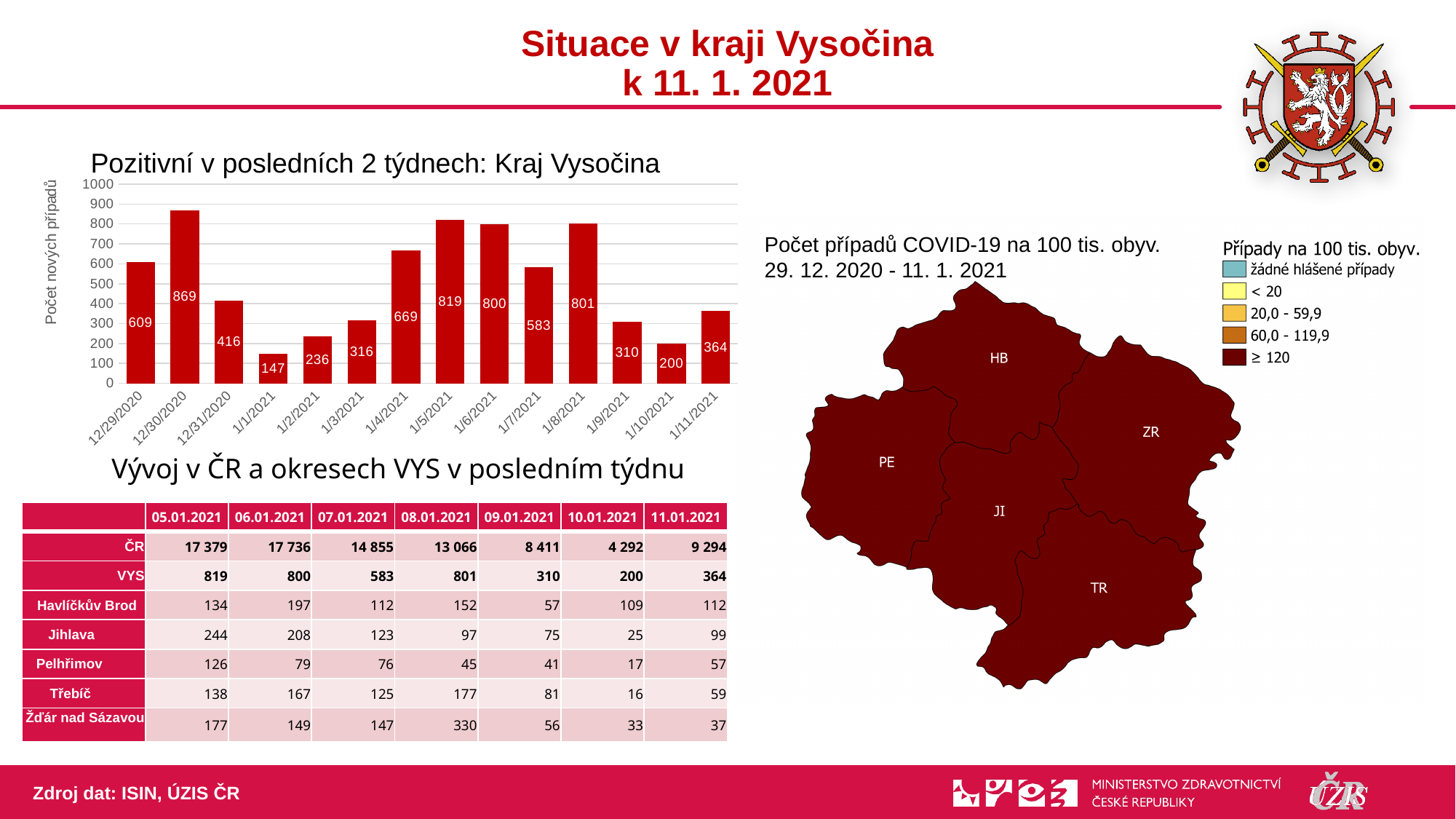
In the chart 'Pozitivní v posledních 2 týdnech: Kraj Vysočina', what is the difference between the values for 12/29/2020 and 12/31/2020? 193 In the chart 'Pozitivní v posledních 2 týdnech: Kraj Vysočina', what is the value for 1/7/2021? 583 In the chart 'Pozitivní v posledních 2 týdnech: Kraj Vysočina', what is the value for 12/30/2020? 869 How many dates (bars) are shown in the chart 'Pozitivní v posledních 2 týdnech: Kraj Vysočina'? 14 In the chart 'Pozitivní v posledních 2 týdnech: Kraj Vysočina', which date has the highest value? 12/30/2020 In the chart 'Pozitivní v posledních 2 týdnech: Kraj Vysočina', what is the value for 1/11/2021? 364 In the chart 'Pozitivní v posledních 2 týdnech: Kraj Vysočina', is the value for 1/7/2021 greater or less than 500? greater What type of chart is 'Pozitivní v posledních 2 týdnech: Kraj Vysočina'? bar chart In the chart 'Pozitivní v posledních 2 týdnech: Kraj Vysočina', which is larger, the value for 12/29/2020 or for 1/4/2021? 1/4/2021 In the chart 'Pozitivní v posledních 2 týdnech: Kraj Vysočina', which date has the lowest value? 1/1/2021 What is the y-axis title of the chart 'Pozitivní v posledních 2 týdnech: Kraj Vysočina'? Počet nových případů In the chart 'Pozitivní v posledních 2 týdnech: Kraj Vysočina', what is the difference between the values for 12/30/2020 and 1/1/2021? 722